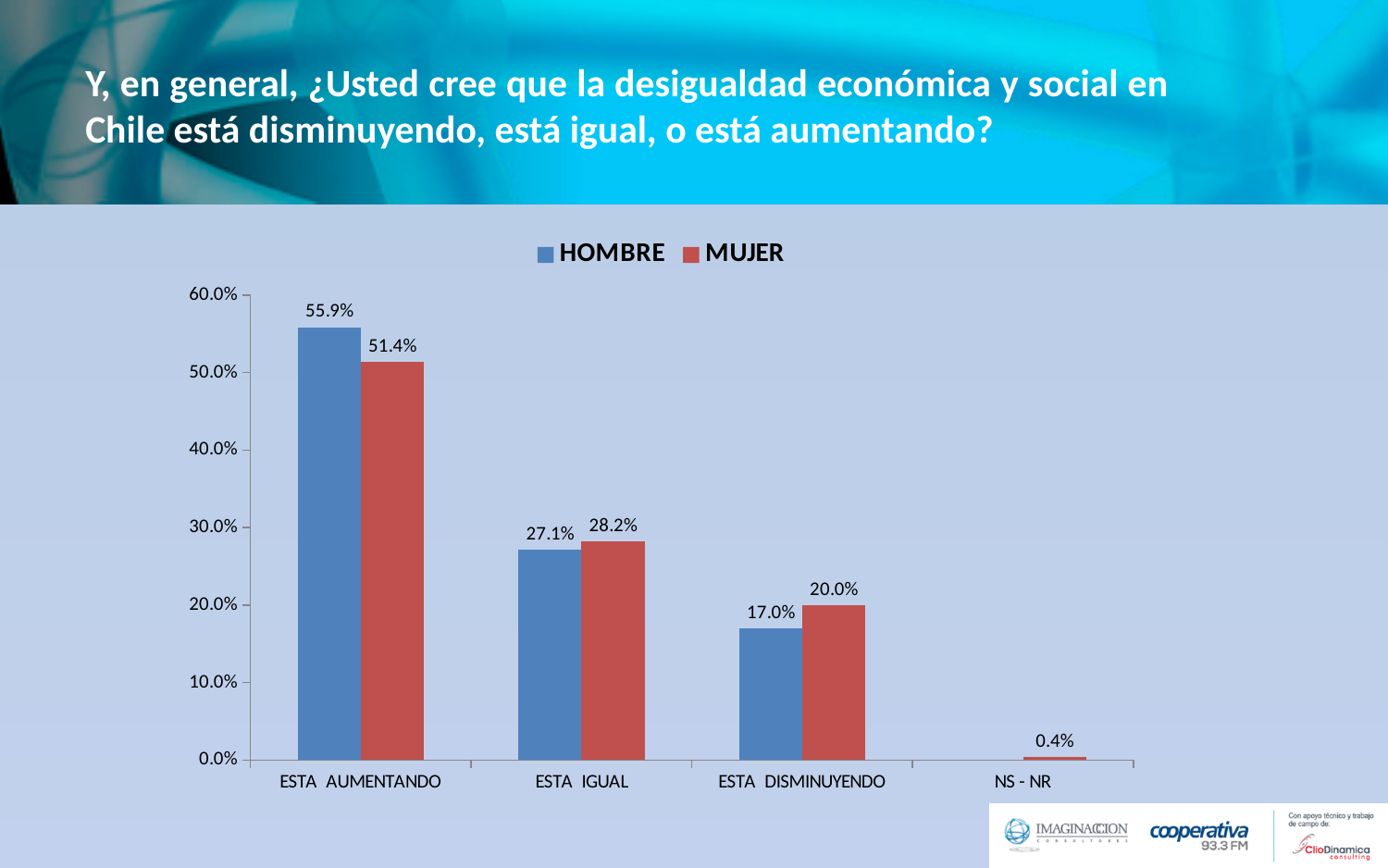
How many categories are shown on the x axis? 4 What is the value for MUJER in the ESTA IGUAL category? 28.2% What is the value for HOMBRE in the ESTA AUMENTANDO category? 55.9% In the ESTA DISMINUYENDO category, which series has the larger value, HOMBRE or MUJER? MUJER How many series does the legend list? 2 Which category has the highest value for MUJER? ESTA AUMENTANDO What is the value for HOMBRE in the ESTA DISMINUYENDO category? 17.0% What kind of chart is shown on the slide? bar chart What is the value for MUJER in the NS - NR category? 0.4% Which category has the lowest value for MUJER? NS - NR Is the MUJER value for ESTA AUMENTANDO greater or less than 50.0%? greater What is the difference between the HOMBRE and MUJER values in the ESTA AUMENTANDO category? 4.5%